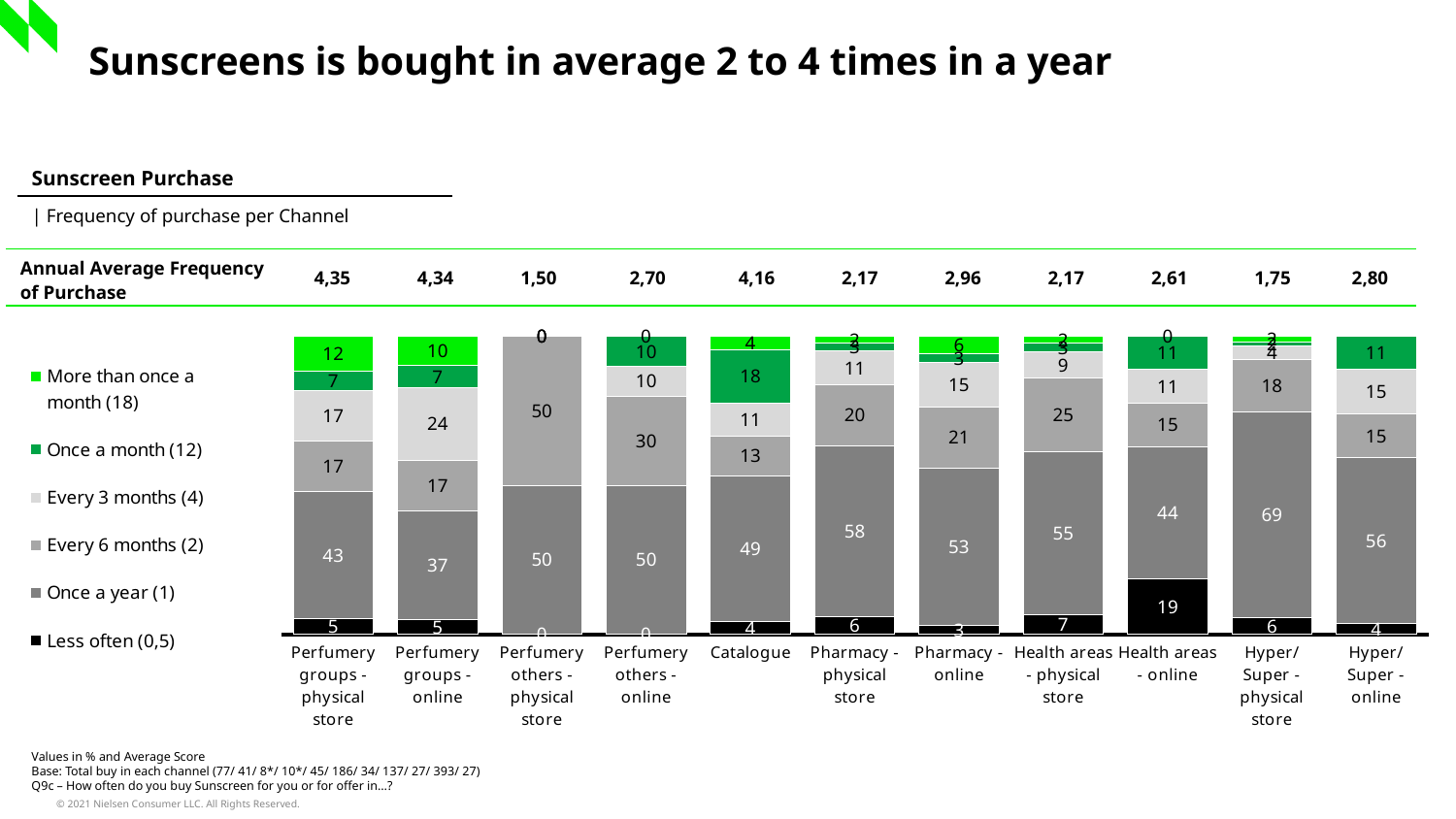
Which channel has the highest 'Once a year (1)' value? Hyper/Super - physical store What is the 'Once a year (1)' value for Pharmacy - physical store? 58 How many channels (categories) are plotted along the x axis? 11 Which has the larger 'Once a year (1)' value, Catalogue or Pharmacy - online? Pharmacy - online What is the 'Once a month (12)' value for Catalogue? 18 What is the 'Once a year (1)' value for Hyper/Super - physical store? 69 What is the 'Less often (0,5)' value for Health areas - online? 19 What is the difference between the 'Every 3 months (4)' values for Perfumery groups - online and Perfumery groups - physical store? 7 What is the 'More than once a month (18)' value for Perfumery groups - physical store? 12 How many series does the legend list? 6 What kind of chart is shown on the slide? Stacked bar chart Which channel has the highest 'Less often (0,5)' value? Health areas - online